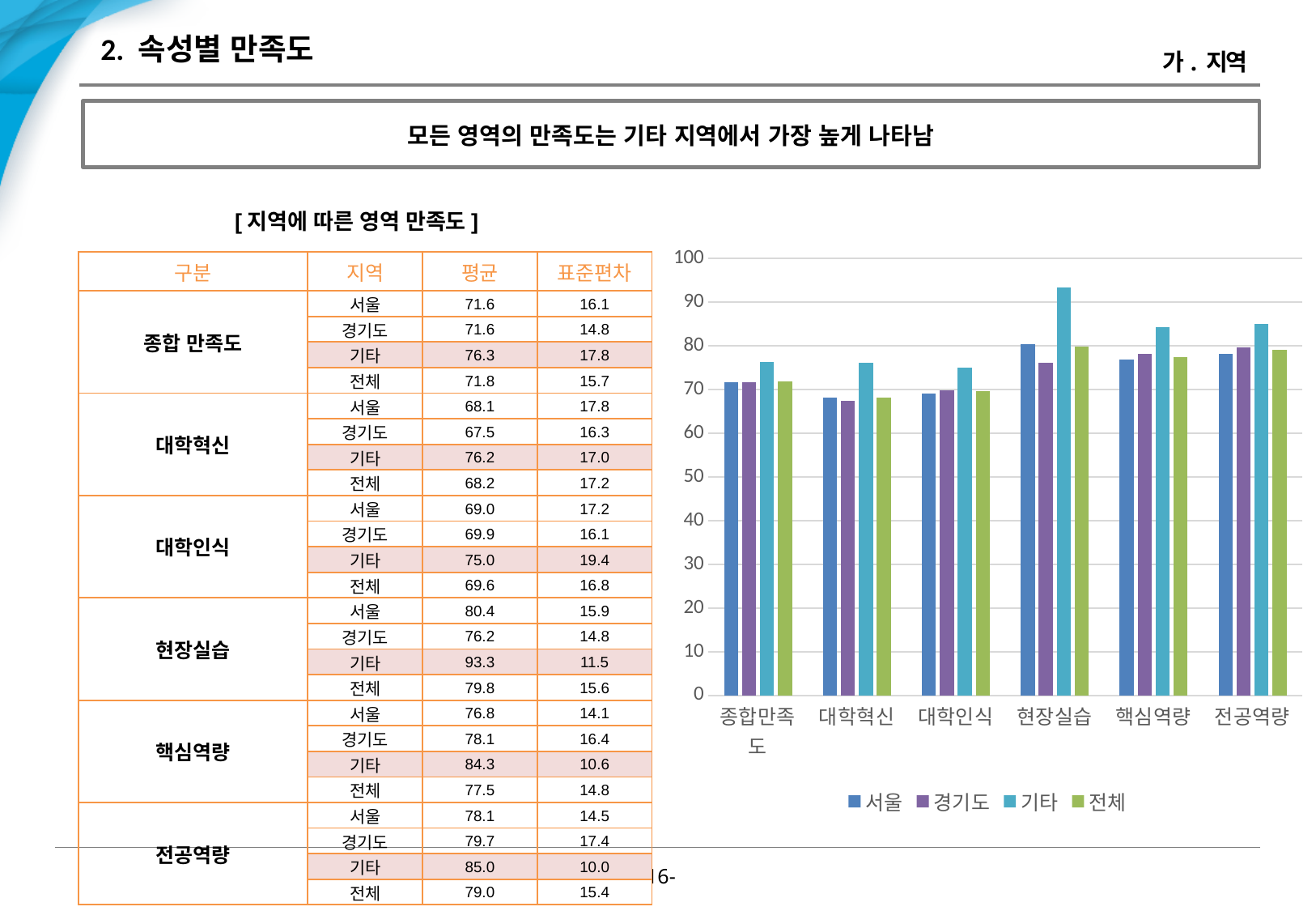
How many categories are shown along the x axis of the chart? 6 What type of chart is shown on the slide? bar chart Is the 서울 value for 대학혁신 greater or less than 70? less What is the 기타 value for 현장실습? 93.3 What is the 전체 value for 핵심역량? 77.5 What is the difference between the 기타 value and the 서울 value for 현장실습? 12.9 How many series does the chart legend list? 4 Which series has the tallest bar in every category of the chart? 기타 In which category is the 기타 bar the highest? 현장실습 Is the 기타 value for 핵심역량 greater or less than 80? greater Which is larger: the 기타 value for 현장실습 or the 기타 value for 종합만족도? 현장실습 Is the 기타 value for 현장실습 greater or less than 90? greater